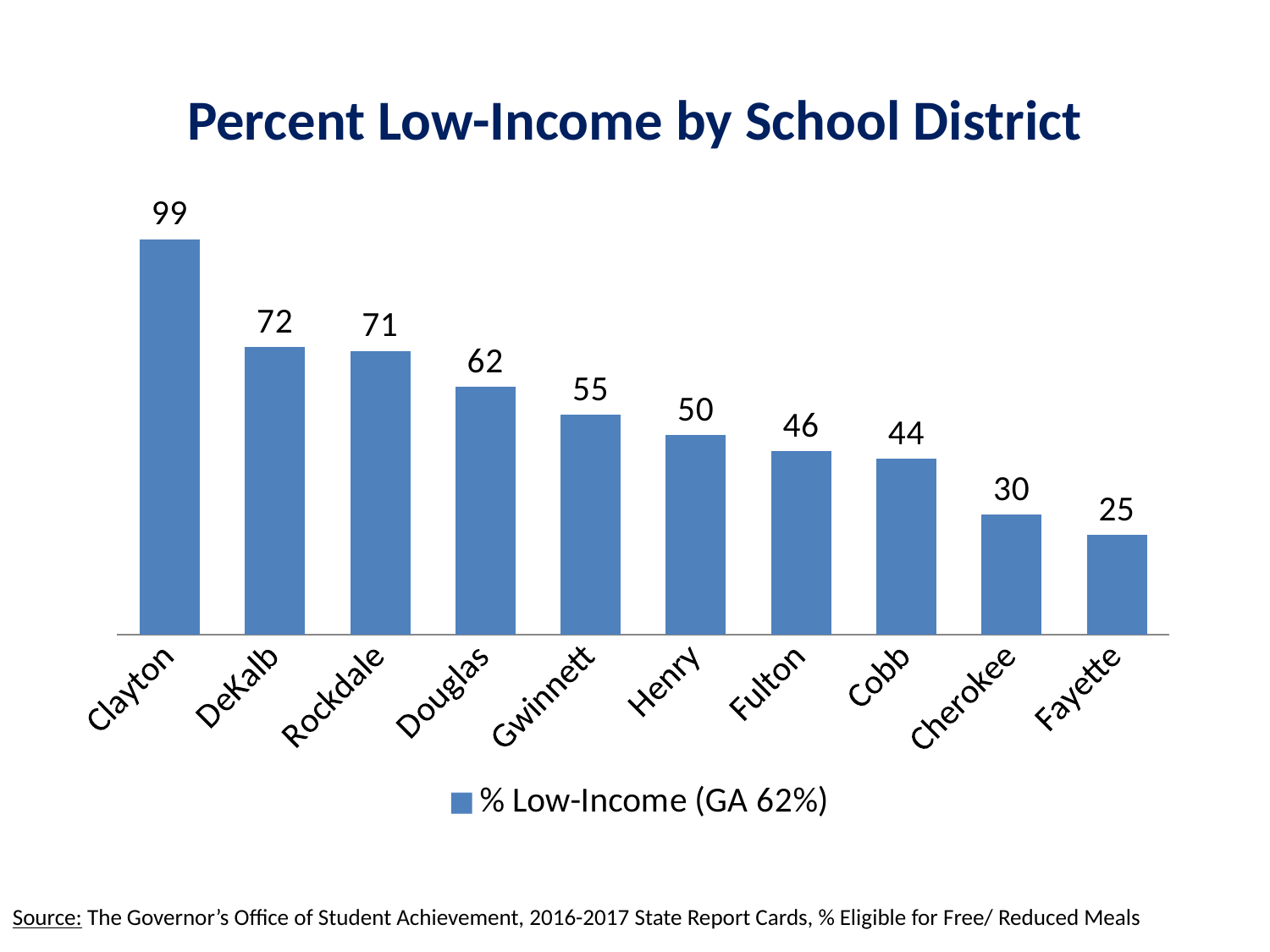
What is the difference between the values for Clayton and Fayette? 74 What is the value for Clayton? 99 What is the value for Cherokee? 30 What is the difference between the values for Douglas and Henry? 12 How many series does the legend list? 1 What kind of chart is shown on the slide? Bar chart What is the value for Gwinnett? 55 Which school district has the lowest percent low-income? Fayette Which is larger, the value for Fulton or the value for Cherokee? Fulton How many school districts are shown in the chart? 10 What is the legend entry for the series? % Low-Income (GA 62%) Which school district has the highest percent low-income? Clayton